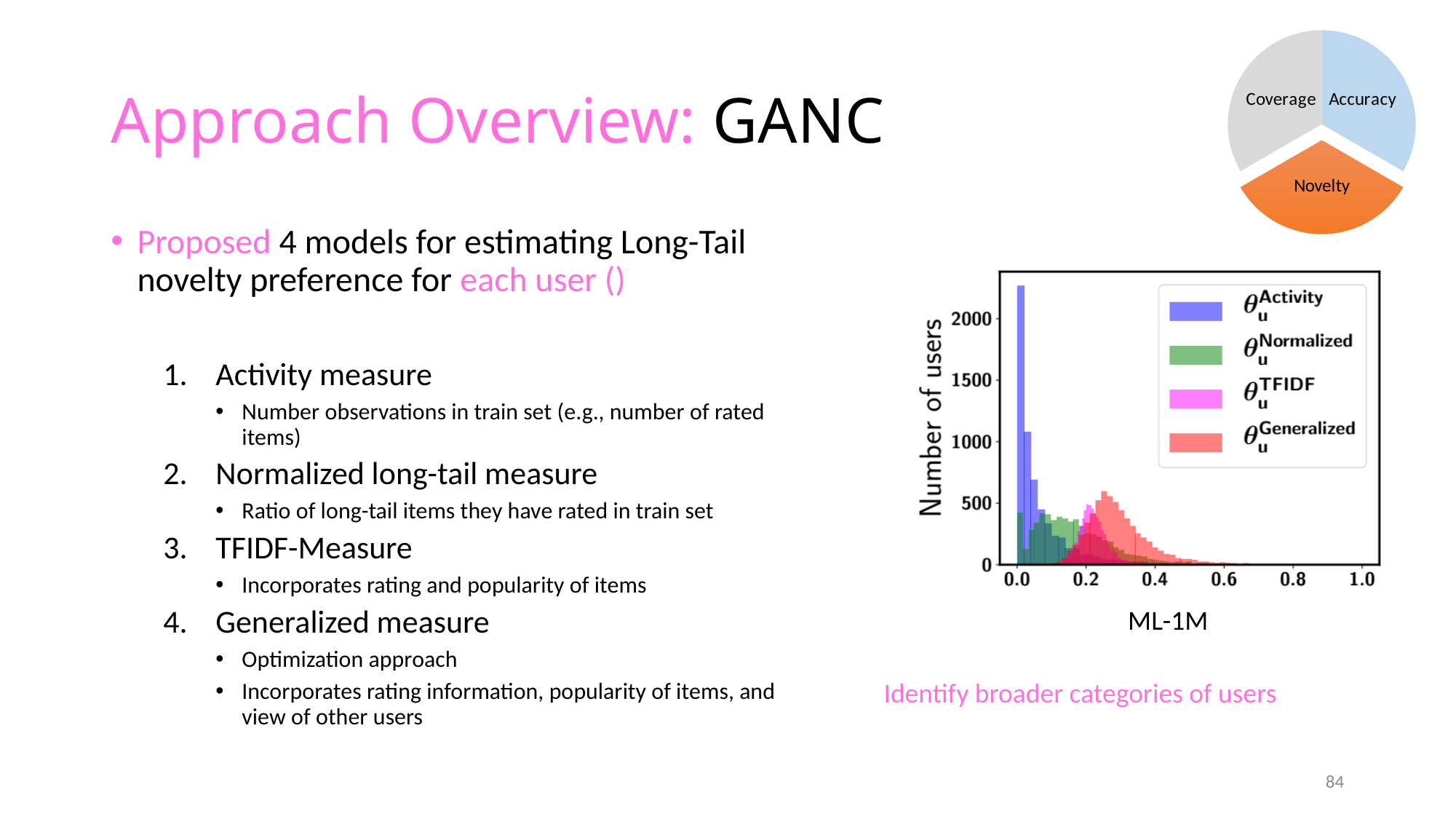
In the ML-1M chart, which series reaches the highest number of users? Activity What kind of chart is shown in the top right corner of the slide? pie chart In the ML-1M chart, is the peak of the Activity series greater or less than 2000? greater In the pie chart in the top right corner, which slice is orange? Novelty What is the y-axis label of the ML-1M chart? Number of users In the ML-1M chart, which series has a higher peak, Activity or Generalized? Activity What kind of chart is the ML-1M chart on the slide? bar chart (histogram) In the ML-1M chart, is the peak of the Normalized series greater or less than 500? less In the ML-1M chart, is the peak of the Generalized series greater or less than 500? greater How many slices does the pie chart in the top right corner have? 3 How many series does the legend of the ML-1M chart list? 4